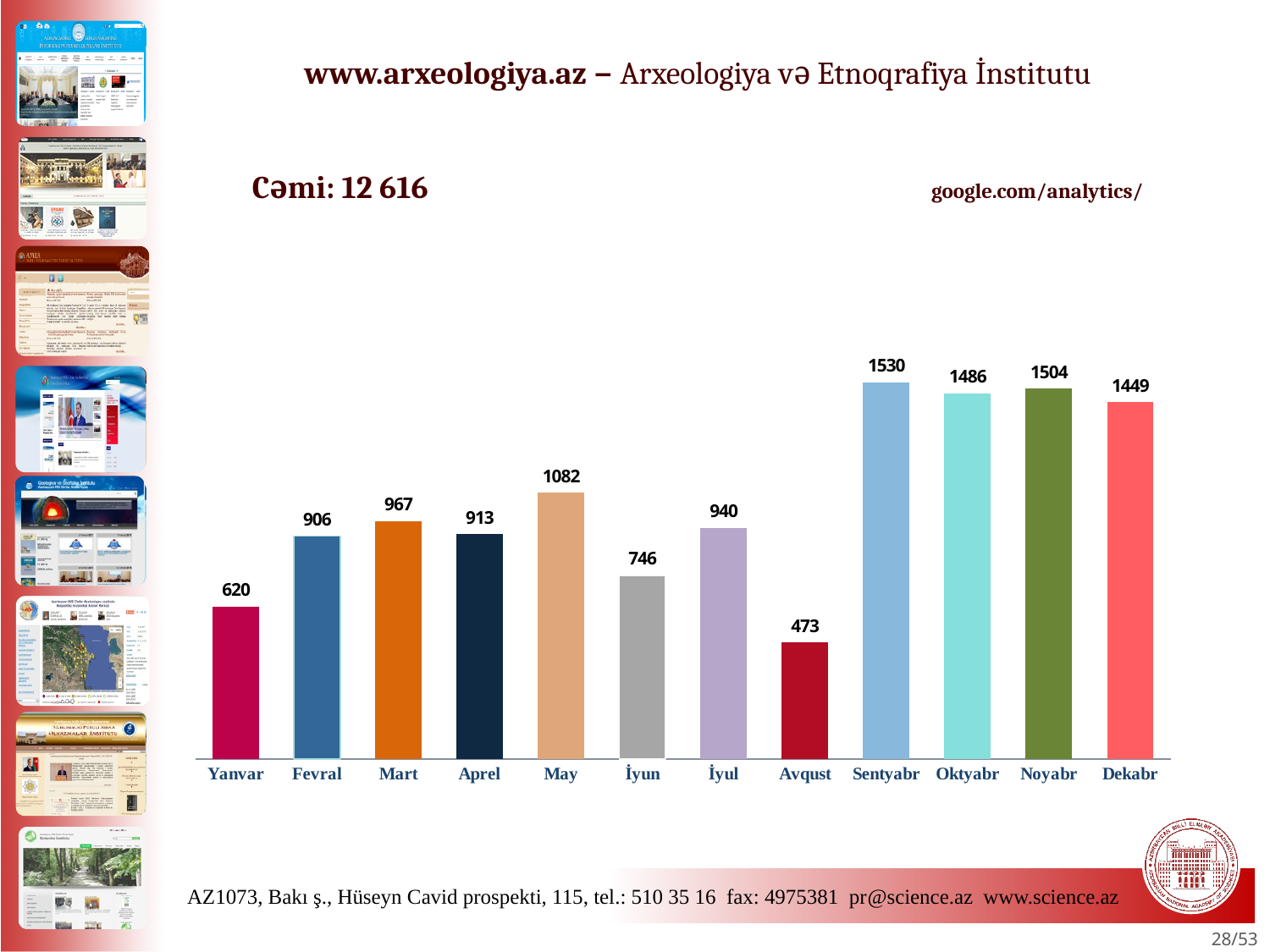
What is the value for Sentyabr? 1530 What is the value for Avqust? 473 Which month has the highest value? Sentyabr How many months are shown on the chart? 12 Which is larger, the value for Noyabr or the value for Oktyabr? Noyabr What total (Cəmi) is stated on the slide? 12 616 What is the difference between the values for Sentyabr and Avqust? 1057 Which is larger, the value for İyul or the value for İyun? İyul What is the difference between the values for Mart and Fevral? 61 What is the value for May? 1082 Which month has the lowest value? Avqust What kind of chart is shown on the slide? bar chart